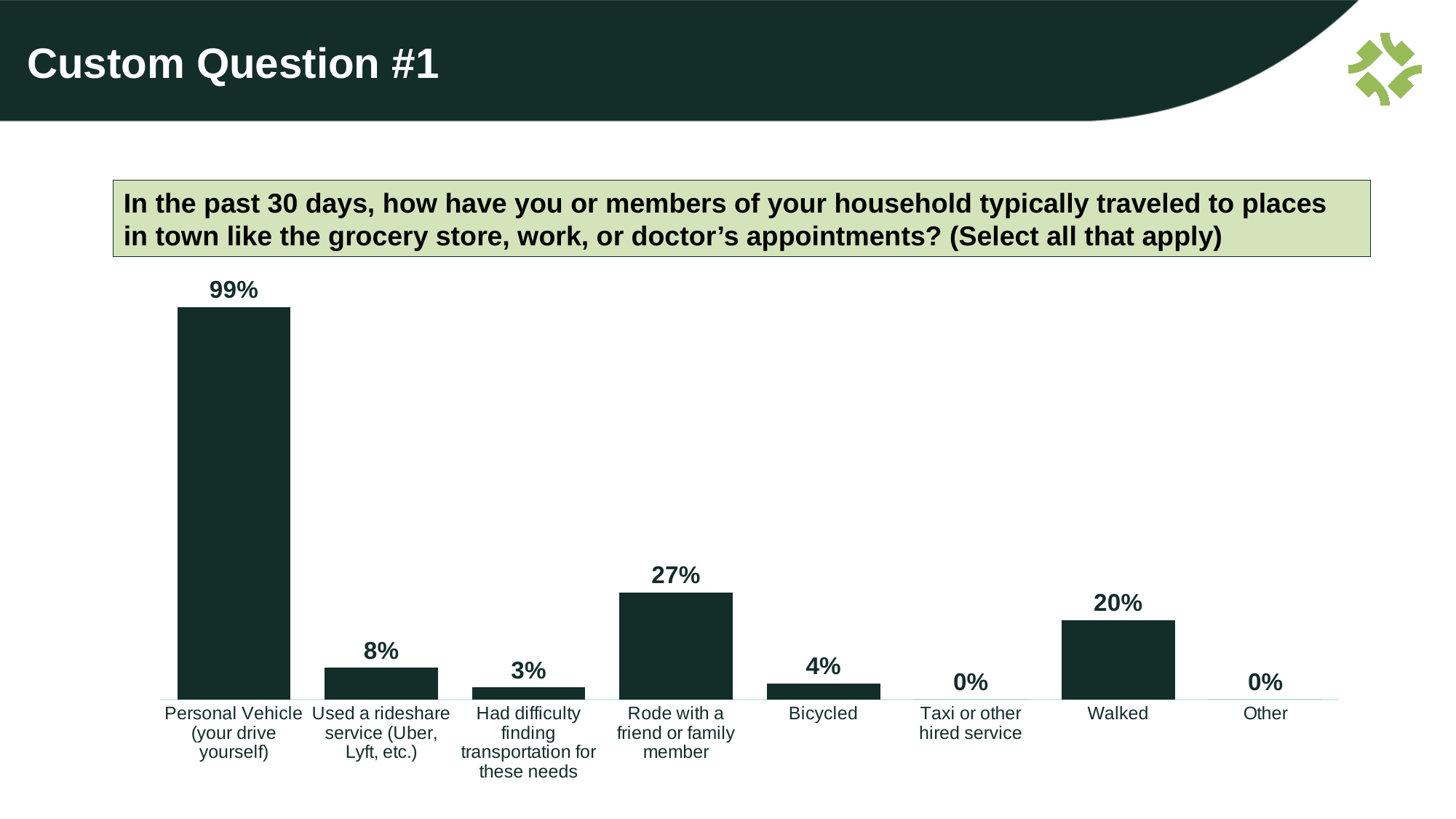
What percentage of respondents selected Personal Vehicle (your drive yourself)? 99% How many categories are shown in the chart? 8 What percentage of respondents Rode with a friend or family member? 27% What kind of chart is shown on the slide? Bar chart Which category has the highest value? Personal Vehicle (your drive yourself) What percentage of respondents Bicycled? 4% What percentage of respondents Used a rideshare service (Uber, Lyft, etc.)? 8% How many categories have a value of 0%? 2 What is the difference between Personal Vehicle (your drive yourself) and Rode with a friend or family member? 72% What percentage of respondents said they Walked? 20% Which is larger: Used a rideshare service (Uber, Lyft, etc.) or Bicycled? Used a rideshare service (Uber, Lyft, etc.) What is the difference between Rode with a friend or family member and Walked? 7%